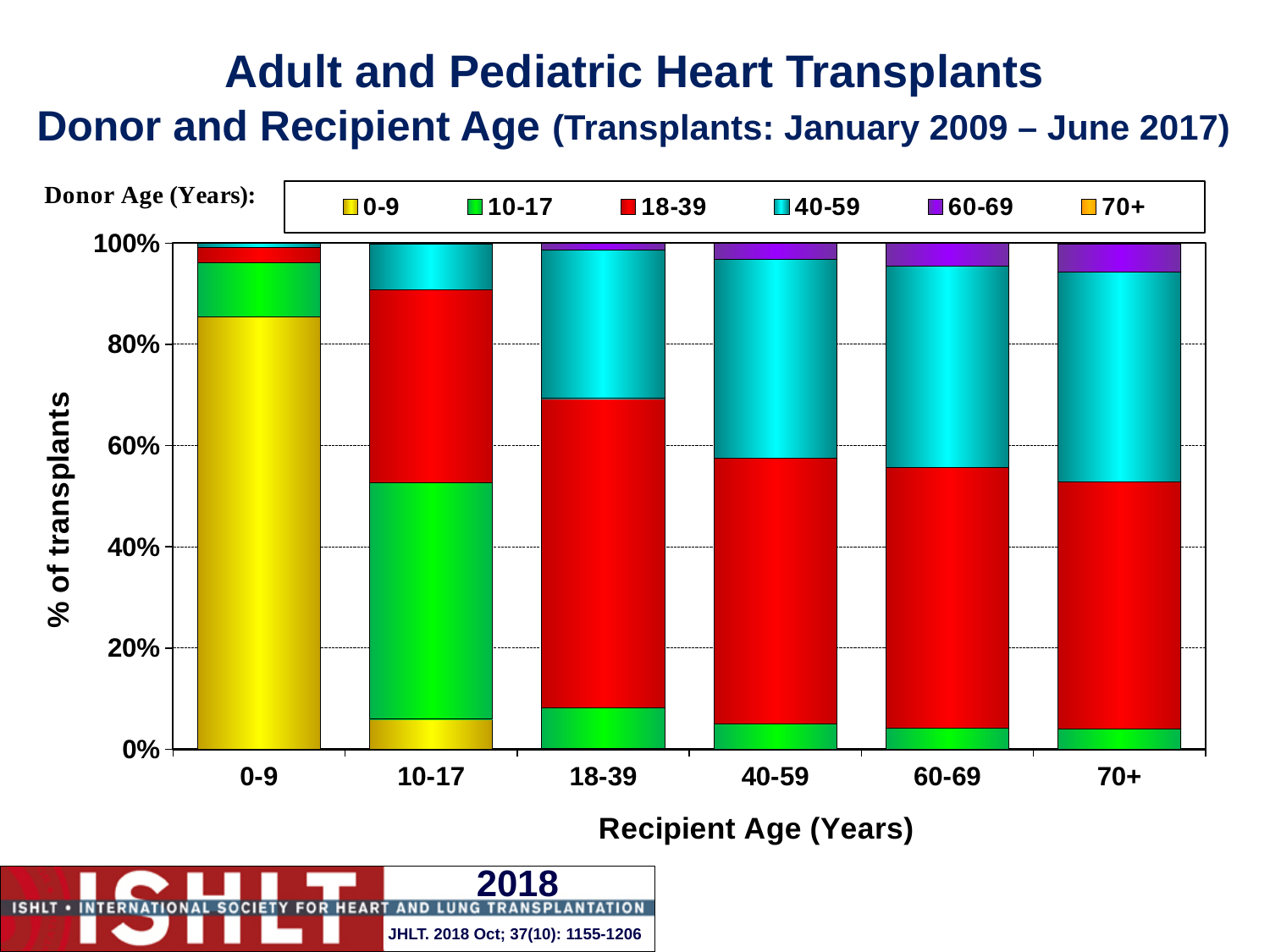
How many donor age groups does the legend list? 6 For recipients aged 70+, is the top of the donor 18-39 segment greater or less than 60%? less Which recipient age group has the largest share of transplants from donors aged 0-9? 0-9 For recipients aged 40-59, which donor age group accounts for a larger share of transplants: 18-39 or 40-59? 18-39 Moving from recipient age 10-17 to 70+, does the share of transplants from donors aged 10-17 rise or fall? fall What is the title of the y axis? % of transplants For recipients aged 18-39, is the top of the donor 18-39 segment greater or less than 60%? greater How many recipient age groups are shown along the x axis? 6 Which recipient age group has the largest share of transplants from donors aged 10-17? 10-17 Which recipient age group has the largest share of transplants from donors aged 18-39? 18-39 What kind of chart is shown on the slide? stacked bar chart For recipients aged 0-9, is the share of transplants from donors aged 0-9 greater or less than 80%? greater